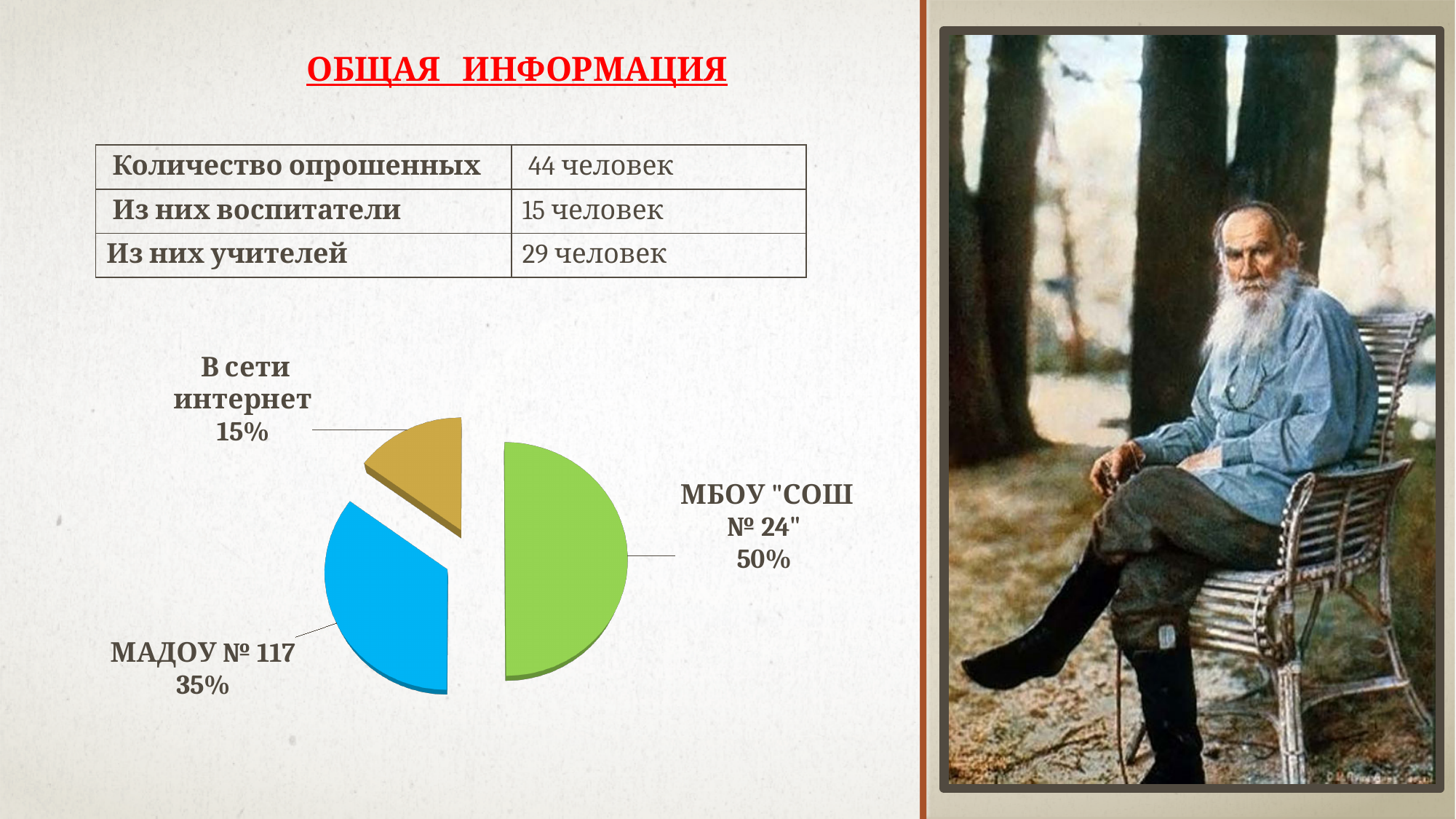
What colour is the slice for МБОУ "СОШ № 24"? green What is the difference in percentage points between МАДОУ № 117 and В сети интернет? 20% How many slices does the pie chart have? 3 Which slice of the pie chart is the smallest? В сети интернет Which slice of the pie chart is the largest? МБОУ "СОШ № 24" What share of the pie does В сети интернет have? 15% What colour is the slice for МАДОУ № 117? blue Which is larger, the share for МАДОУ № 117 or the share for В сети интернет? МАДОУ № 117 What share of the pie does МБОУ "СОШ № 24" have? 50% What is the difference in percentage points between МБОУ "СОШ № 24" and МАДОУ № 117? 15% What share of the pie does МАДОУ № 117 have? 35% What kind of chart is shown on the slide? pie chart